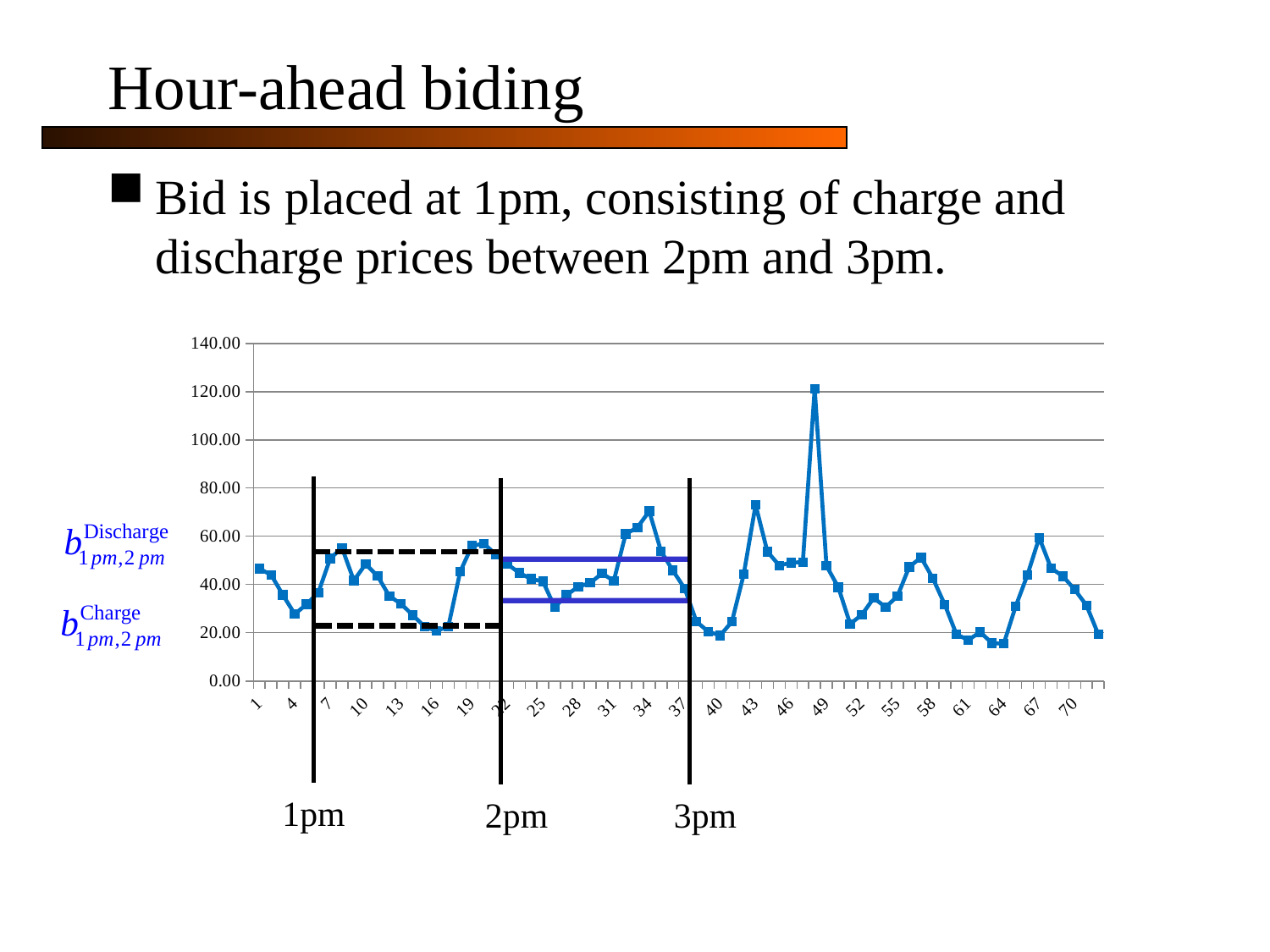
Is the value at x-axis point 40 greater or less than 40? less What is the highest tick value shown on the y-axis? 140.00 What time labels are written under the three vertical lines on the chart? 1pm, 2pm, 3pm What kind of chart is shown on the slide? line chart Which is larger, the value at x-axis point 34 or the value at x-axis point 40? 34 Is the value at x-axis point 34 greater or less than 60? greater Is the value at x-axis point 64 greater or less than 20? less